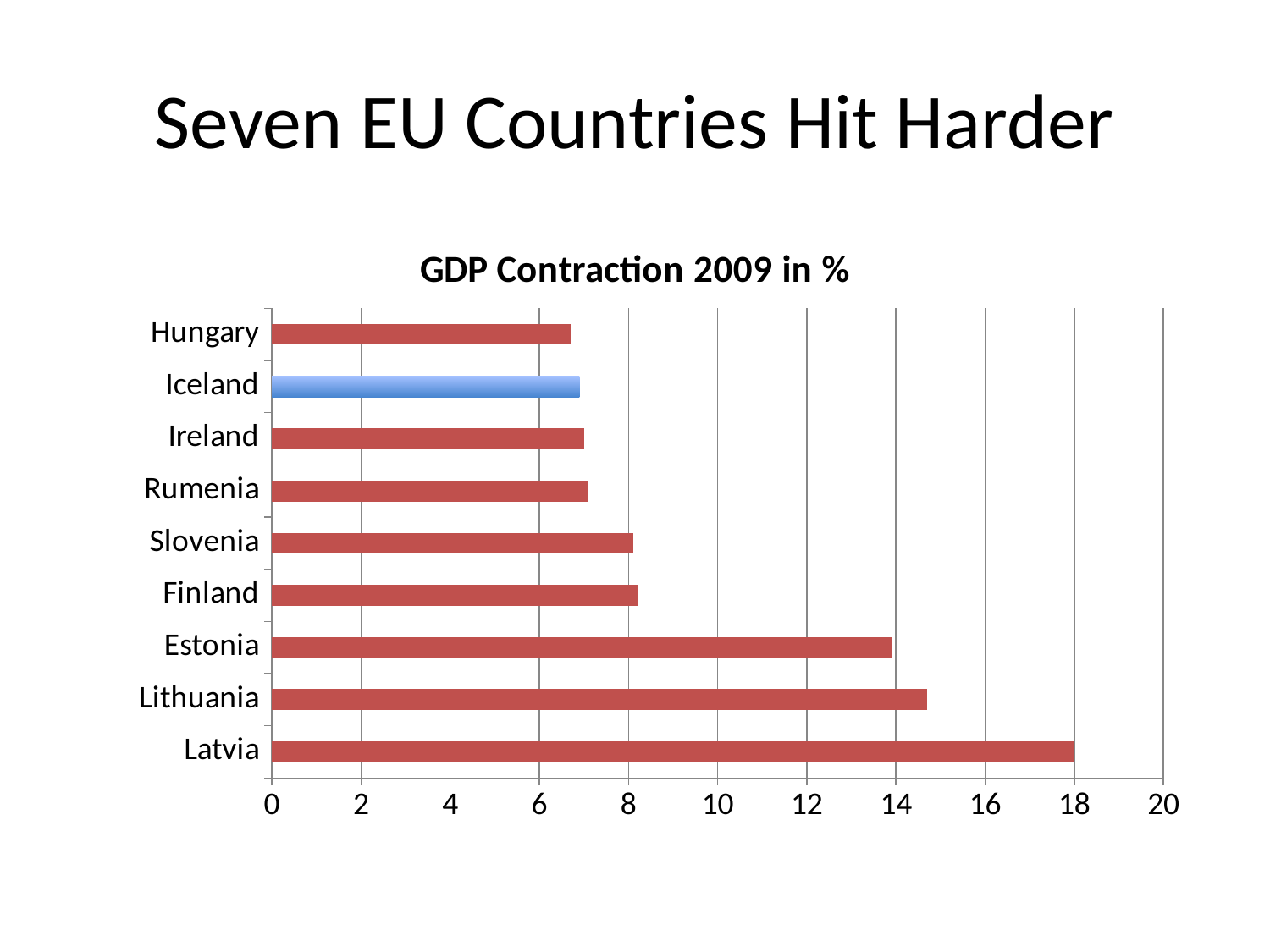
What kind of chart is shown on the slide? bar chart What is the GDP contraction value for Latvia? 18 Which has a larger value, Estonia or Lithuania? Lithuania Which country's bar is shown in a different colour (blue) from the others? Iceland What is the title of the chart? GDP Contraction 2009 in % How many countries are shown in the chart? 9 Which has a larger value, Finland or Latvia? Latvia Is the value for Lithuania greater or less than 14? greater Which country has the highest GDP contraction in the chart? Latvia Is the value for Ireland greater or less than 8? less